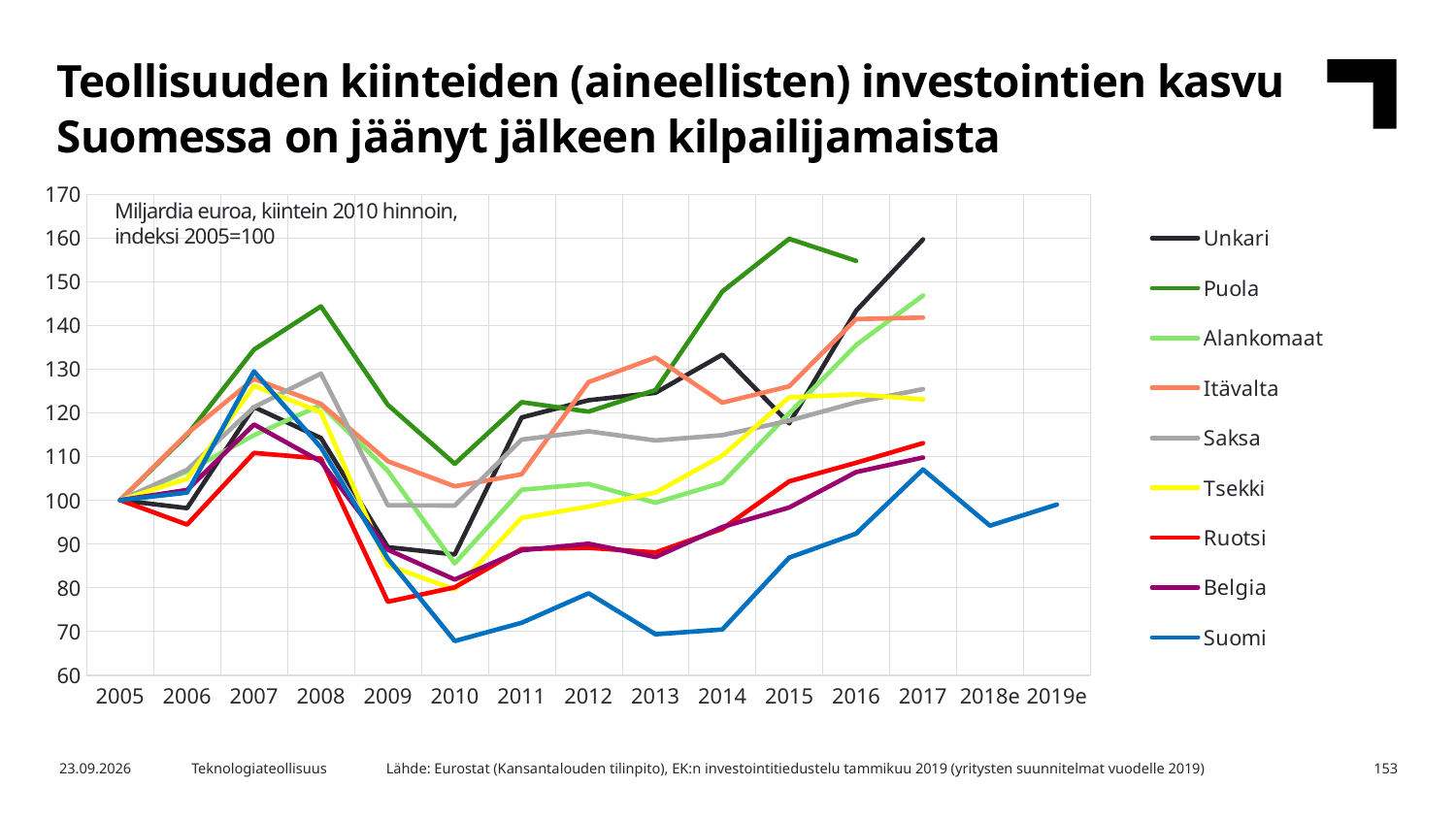
What is the index value for all countries in 2005? 100 Which is larger in 2014, the value for Puola or the value for Suomi? Puola Which country has the highest value in 2015? Puola Is the value for Suomi in 2018e greater or less than 100? less Is the value for Puola in 2015 greater or less than 150? greater Which country has the lowest value in 2017? Suomi Which country has the lowest value in 2010? Suomi How many series does the legend list? 9 How many years (categories) are shown on the x axis? 15 What kind of chart is shown on the slide? line chart Is the value for Suomi in 2010 greater or less than 80? less Does the value for Puola rise or fall from 2008 to 2010? fall